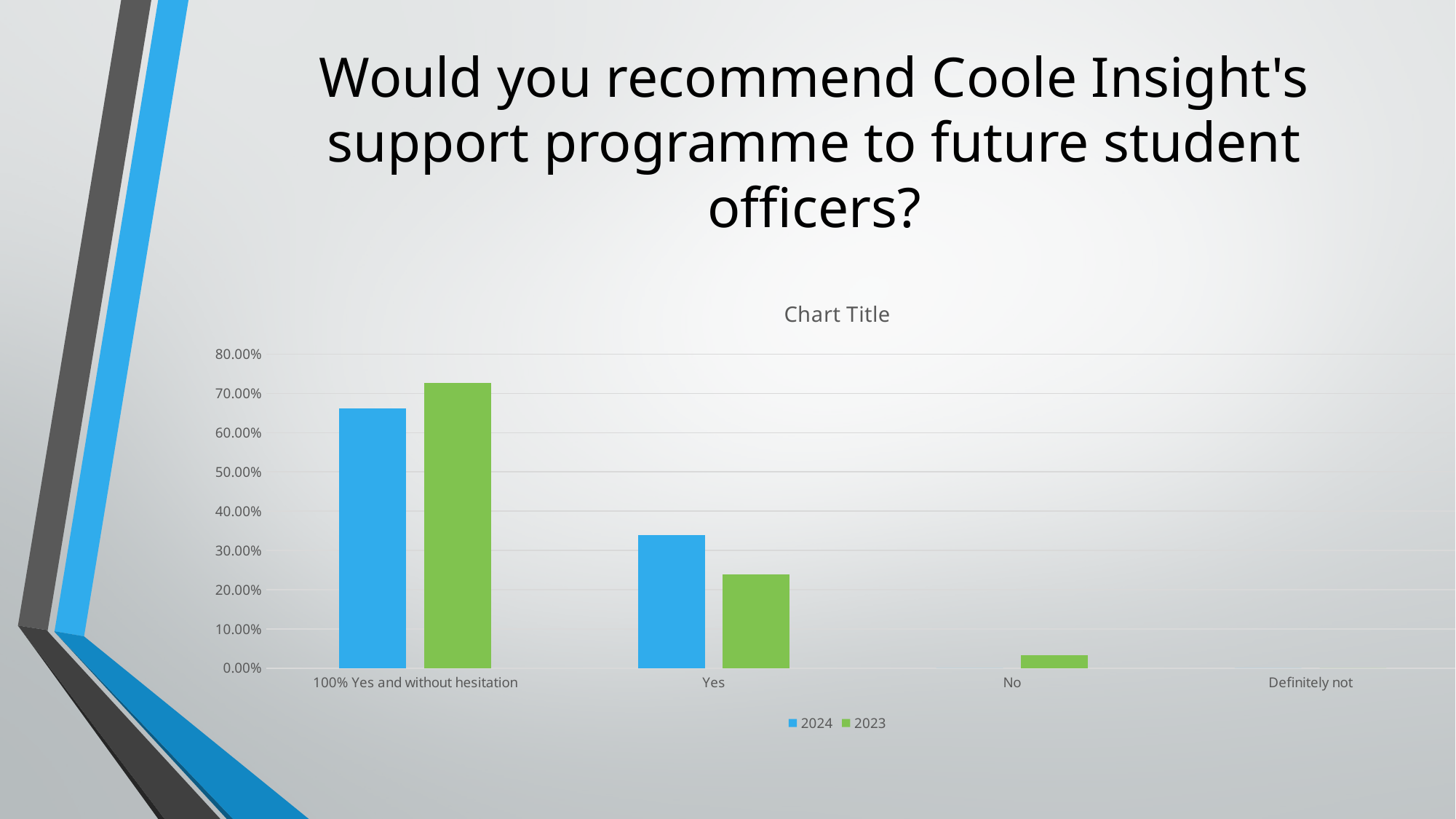
For the category '100% Yes and without hesitation', which series has the larger value, 2024 or 2023? 2023 Do the 2023 values rise or fall moving from '100% Yes and without hesitation' to 'Definitely not' along the x axis? fall What kind of chart is shown on the slide? bar chart Which category has the highest value for the 2024 series? 100% Yes and without hesitation Which category has the highest value for the 2023 series? 100% Yes and without hesitation Is the 2024 value for '100% Yes and without hesitation' greater or less than 60.00%? greater Is the 2023 value for 'Yes' greater or less than 30.00%? less Which colour represents the 2024 series in the legend? blue Is the 2023 value for 'No' greater or less than 10.00%? less How many series does the legend list? 2 How many categories are shown on the x axis? 4 For the category 'Yes', which series has the larger value, 2024 or 2023? 2024